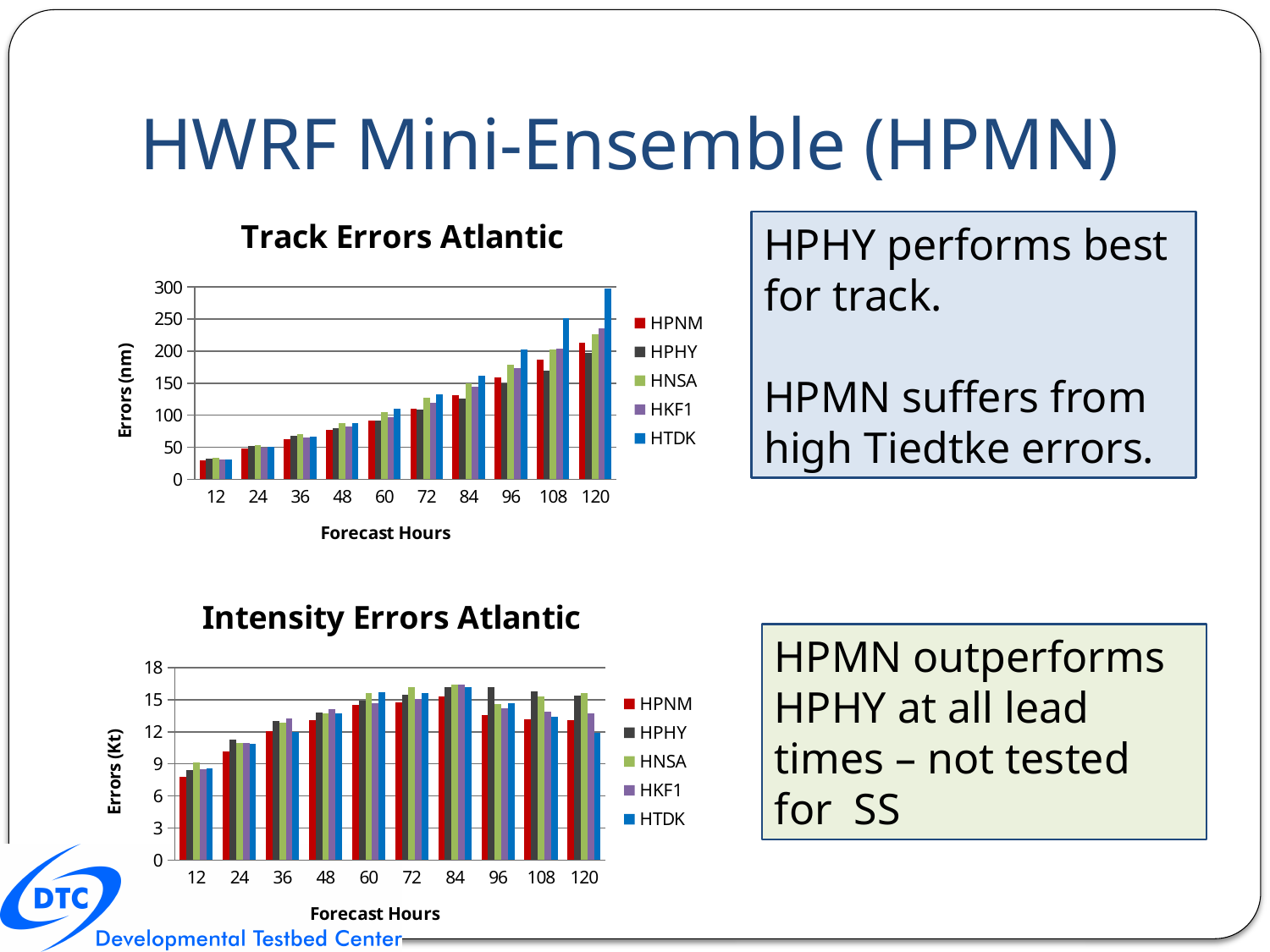
How many series does the legend of the Intensity Errors Atlantic chart list? 5 How many forecast-hour categories are shown on the x axis of the Track Errors Atlantic chart? 10 In the Track Errors Atlantic chart, is the HTDK value at 108 forecast hours greater or less than 200? greater In the Intensity Errors Atlantic chart, at 120 forecast hours, which is larger: HNSA or HTDK? HNSA In the Intensity Errors Atlantic chart, which series has the lowest bar at 120 forecast hours? HTDK In the Track Errors Atlantic chart, which series has the highest bar at 120 forecast hours? HTDK What is the y-axis label of the Intensity Errors Atlantic chart? Errors (Kt) What kind of chart is the Track Errors Atlantic chart? bar chart In the Intensity Errors Atlantic chart, is the HPNM value at 12 forecast hours greater or less than 9? less In the Track Errors Atlantic chart, is the HPNM value at 12 forecast hours greater or less than 50? less In the Track Errors Atlantic chart, do the errors generally rise or fall as forecast hours increase? rise In the Track Errors Atlantic chart, at 108 forecast hours, which is larger: HTDK or HPNM? HTDK